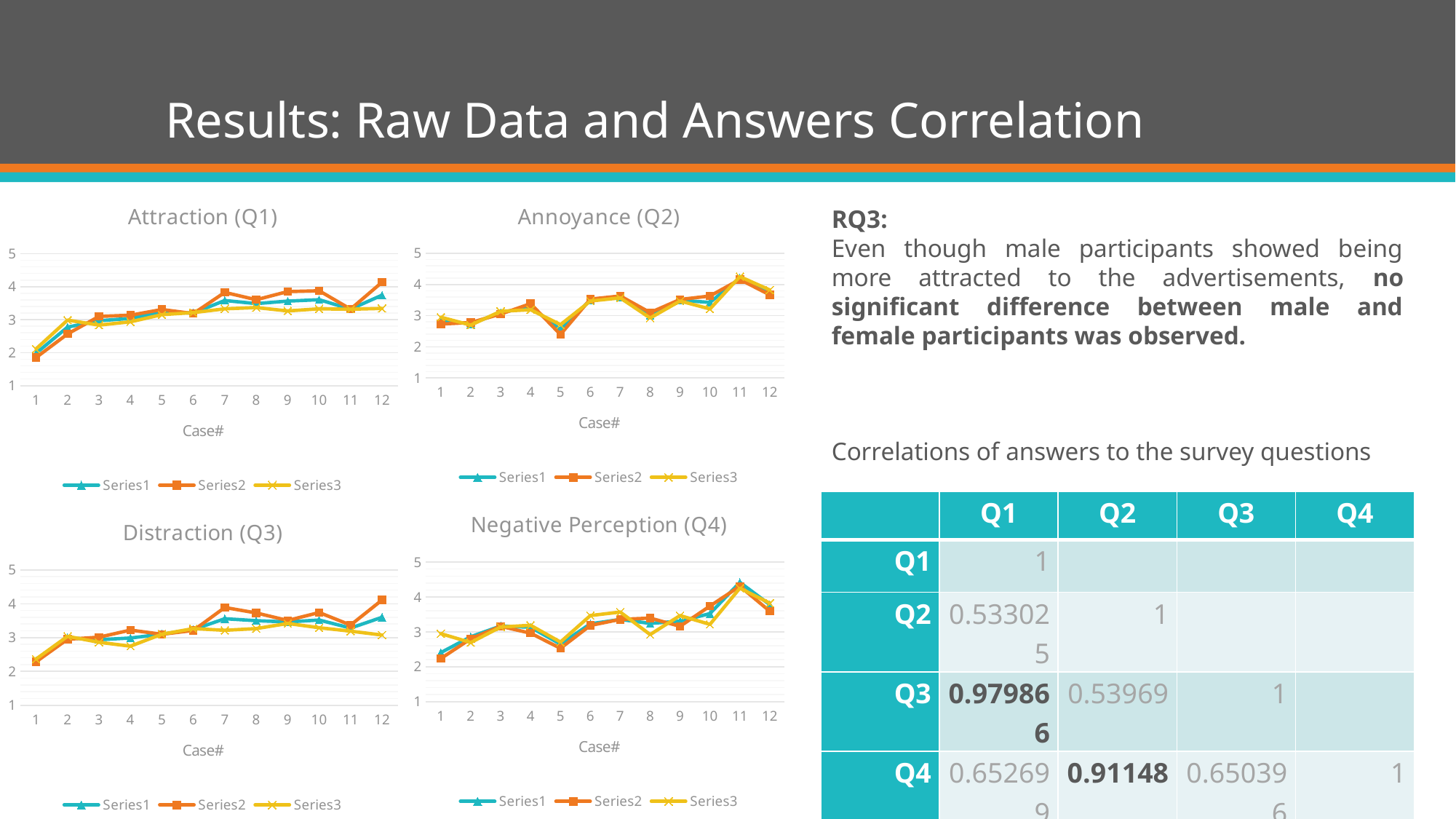
How many cases are plotted along the x axis of the Annoyance (Q2) chart? 12 In the Annoyance (Q2) chart, is the value of Series2 at case 5 greater or less than 3? less In the Annoyance (Q2) chart, is the value of Series3 at case 11 greater or less than 4? greater What is the x-axis label of the Negative Perception (Q4) chart? Case# In the Attraction (Q1) chart, do the values generally rise or fall from case 1 to case 12? rise How many series does the legend of the Distraction (Q3) chart list? 3 In the Distraction (Q3) chart, is the value of Series2 at case 1 greater or less than 3? less What kind of chart is the Attraction (Q1) chart? line chart